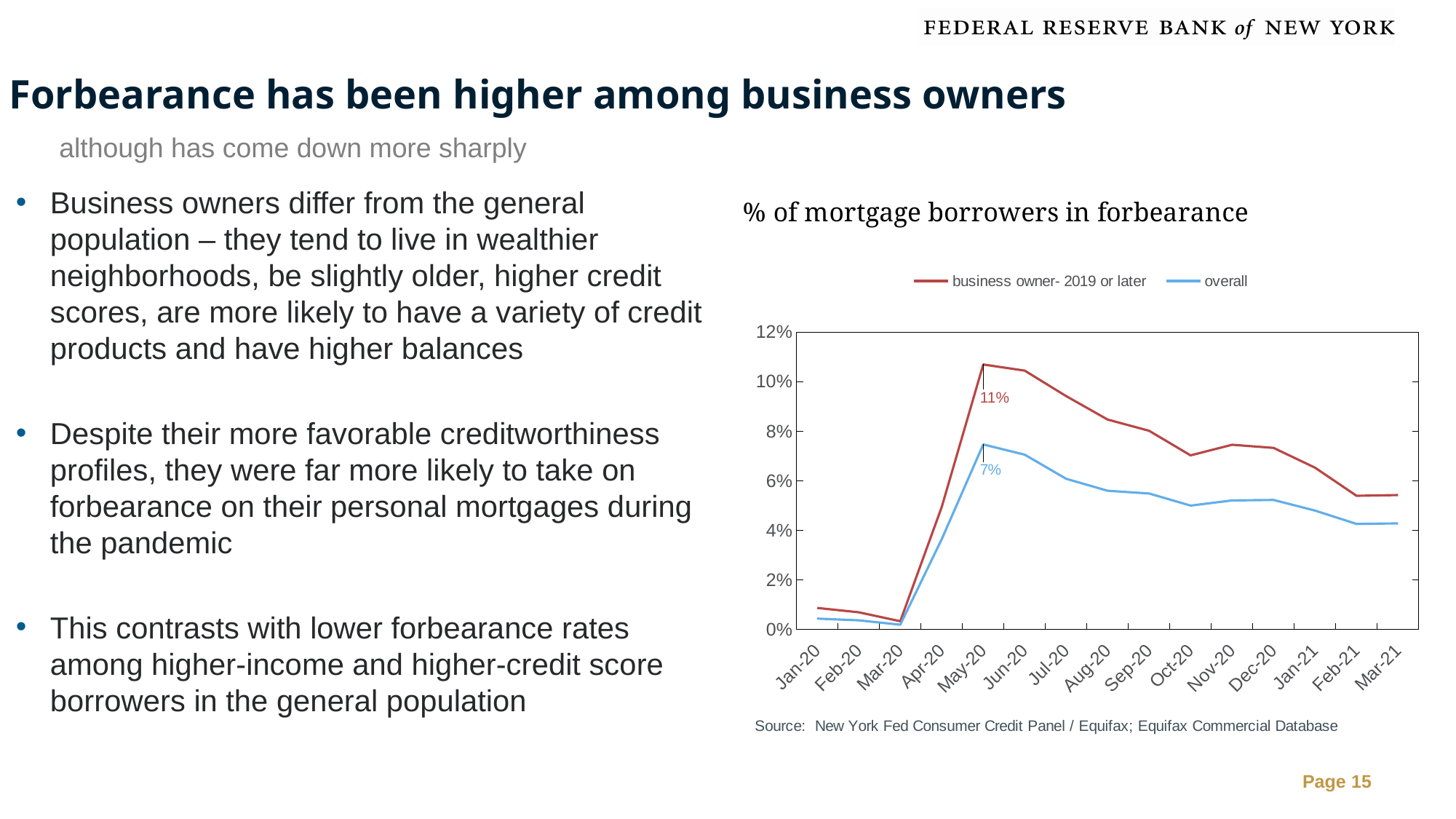
How many months are plotted along the x axis? 15 Is the value for business owner- 2019 or later in Mar-21 greater or less than 4%? greater Is the value for overall in Mar-21 greater or less than 6%? less Does the business owner- 2019 or later series rise or fall from May-20 to Mar-21? fall What is the value for business owner- 2019 or later in May-20? 11% How many series does the legend list? 2 In May-20, which series has the higher value, business owner- 2019 or later or overall? business owner- 2019 or later In which month does the business owner- 2019 or later series reach its highest value? May-20 What is the value for overall in May-20? 7% What kind of chart is shown on the slide? line chart What is the difference between the business owner- 2019 or later value and the overall value in May-20? 3 percentage points What is the title of the chart? % of mortgage borrowers in forbearance